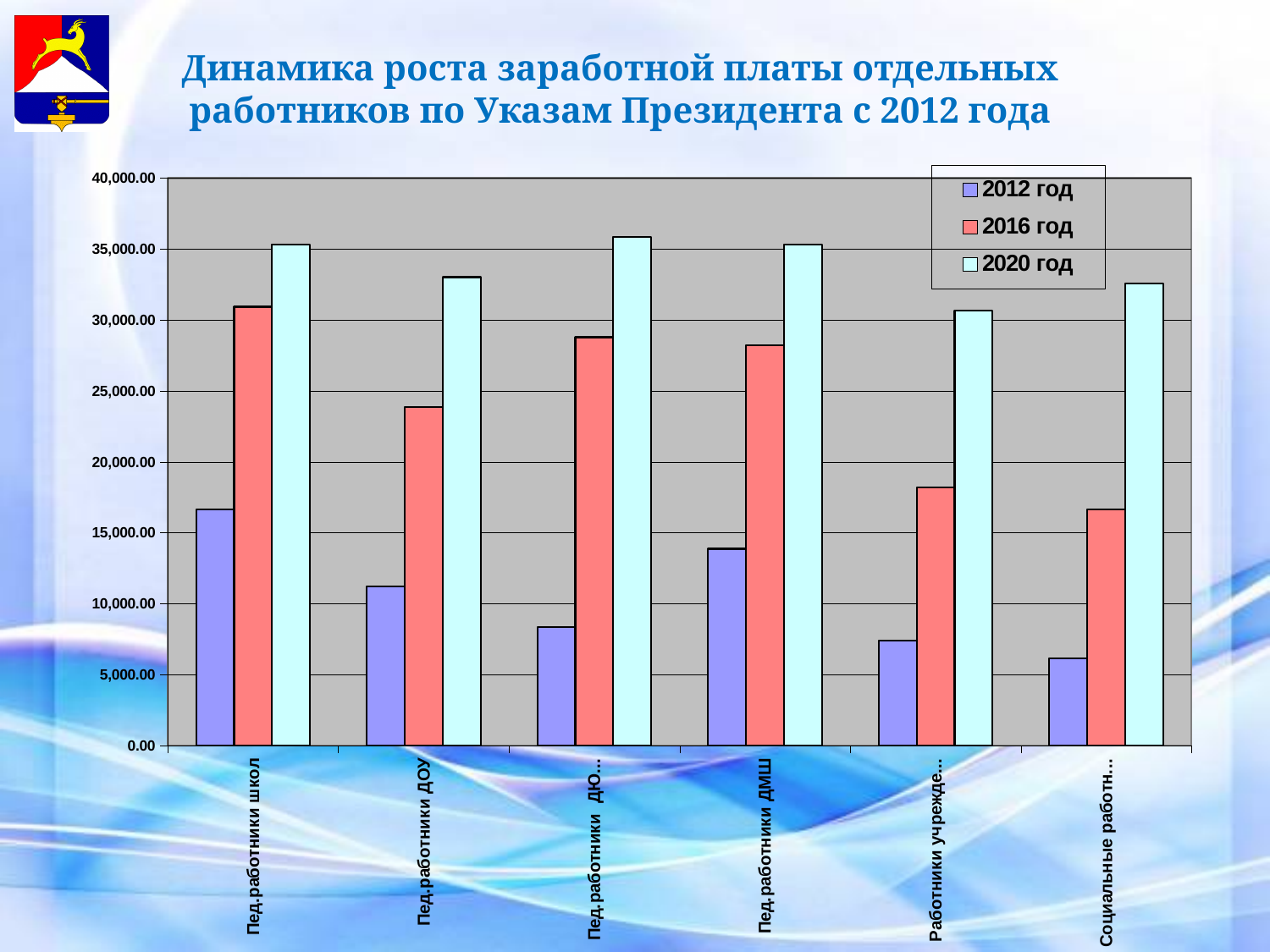
Is the 2012 год value for Пед.работники ДМШ greater or less than 15,000.00? less Is the 2020 год value for Пед.работники ДОУ greater or less than 30,000.00? greater Which category has the highest 2012 год value? Пед.работники школ Which colour represents the 2016 год series? red How many categories are plotted along the x axis? 6 How many series does the legend list? 3 Is the 2012 год value for Пед.работники школ greater or less than 15,000.00? greater What kind of chart is shown on the slide? bar chart Which series does the legend list first? 2012 год Which is larger: the 2016 год value for Пед.работники школ or the 2016 год value for Пед.работники ДОУ? Пед.работники школ For Пед.работники школ, do the values rise or fall from 2012 год to 2020 год? rise